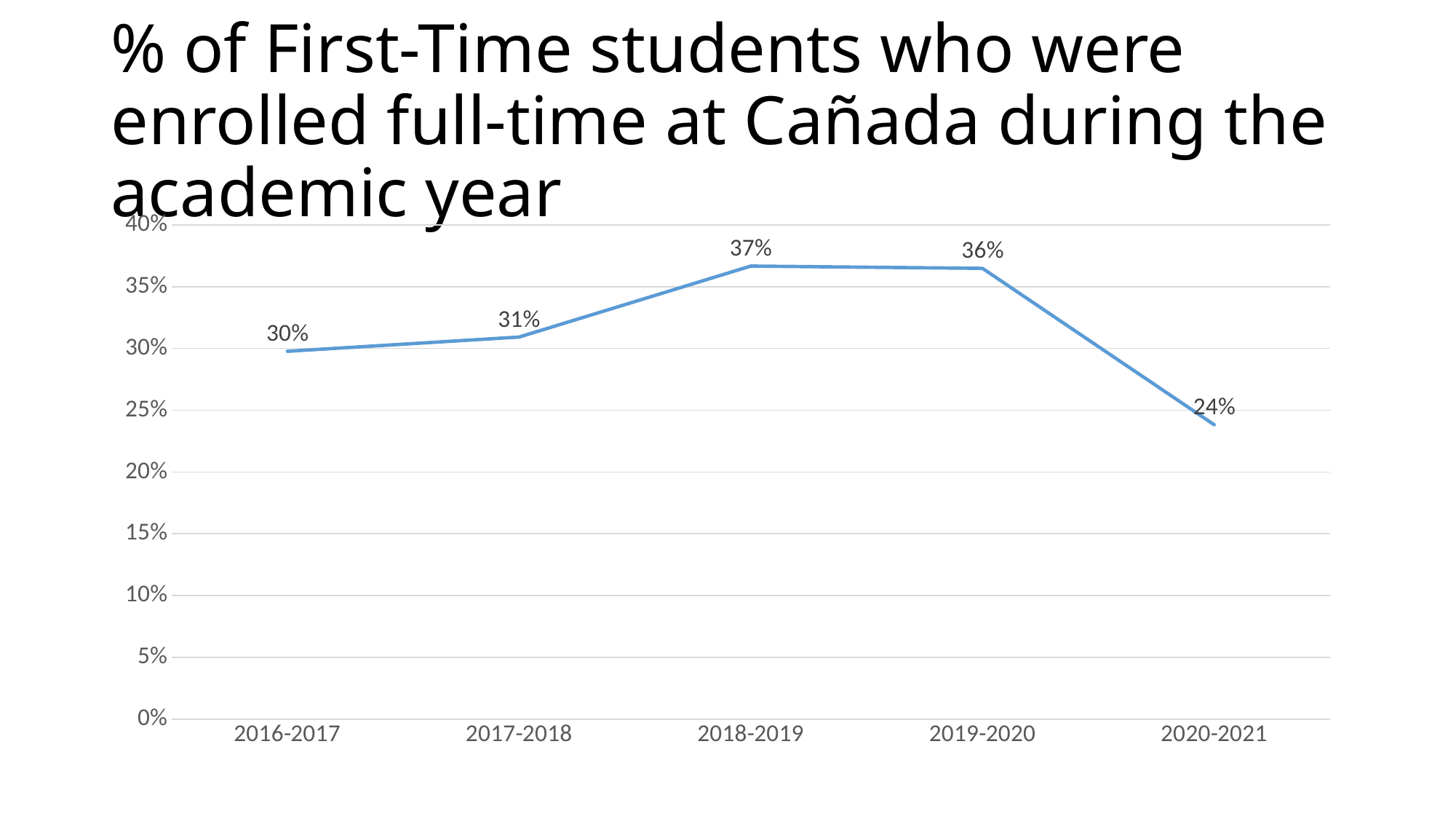
What is the value for 2019-2020? 36% Which academic year has the highest value? 2018-2019 What is the value for 2018-2019? 37% How many academic years are plotted on the chart? 5 Which is larger, the value for 2017-2018 or the value for 2020-2021? 2017-2018 Which academic year has the lowest value? 2020-2021 Is the value for 2020-2021 greater or less than 25%? less What is the difference between the values for 2018-2019 and 2020-2021? 13% What is the value for 2020-2021? 24% What is the value for 2016-2017? 30% Does the value rise or fall from 2019-2020 to 2020-2021? fall What kind of chart is shown on the slide? line chart